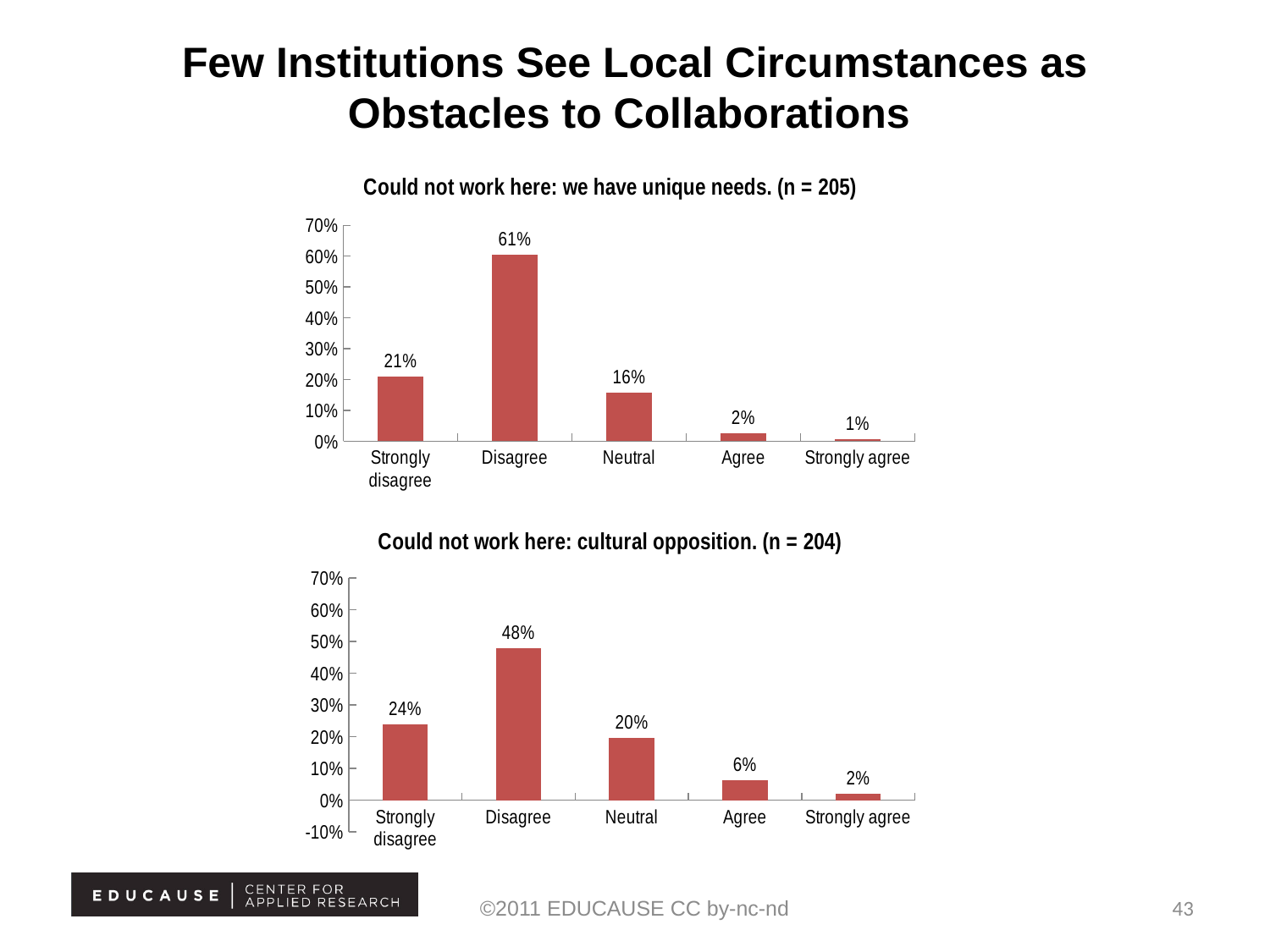
How many categories are shown on the x axis of the bottom chart? 5 In the chart titled "Could not work here: we have unique needs. (n = 205)", what is the value for Disagree? 61% In the chart titled "Could not work here: cultural opposition. (n = 204)", what is the value for Neutral? 20% What kind of chart is the top chart? Bar chart In the bottom chart, which is larger: the value for Strongly disagree or the value for Neutral? Strongly disagree In the top chart, which category has the highest value? Disagree In the bottom chart, what is the difference between the values for Strongly disagree and Agree? 18% In the top chart, what is the value for Strongly agree? 1% What is the title of the bottom chart? Could not work here: cultural opposition. (n = 204) In the top chart, what is the difference between the values for Disagree and Strongly disagree? 40% In the bottom chart, which category has the lowest value? Strongly agree In the top chart, is the value for Disagree greater or less than 50%? greater